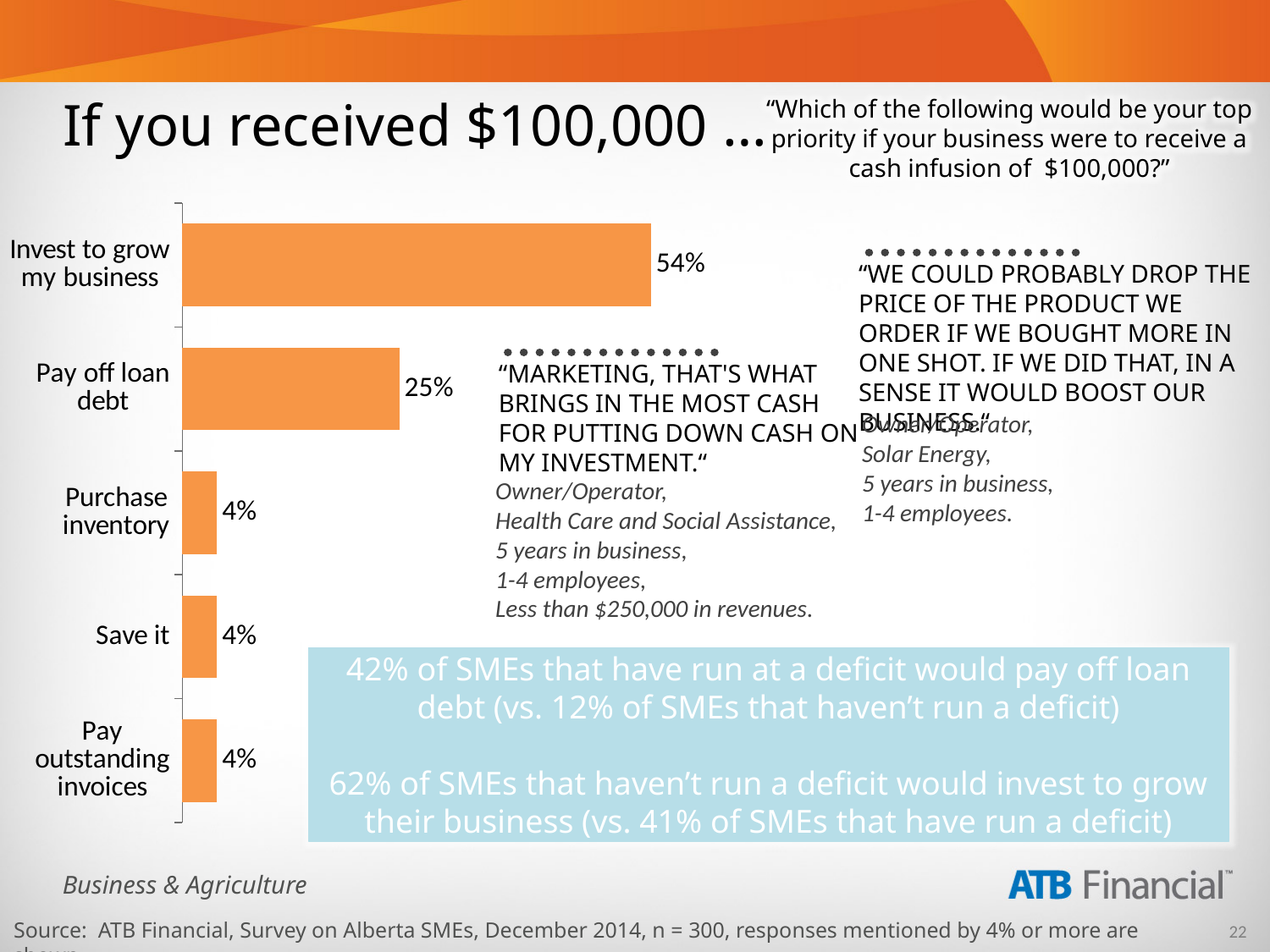
What is the difference between the values for 'Pay off loan debt' and 'Pay outstanding invoices'? 21 percentage points What percentage of respondents said they would invest to grow their business? 54% Which is larger: the value for 'Pay off loan debt' or the value for 'Save it'? Pay off loan debt What percentage of respondents said they would purchase inventory? 4% What kind of chart is shown on the slide? Bar chart What is the difference between the values for 'Invest to grow my business' and 'Pay off loan debt'? 29 percentage points How many categories are shown in the chart? 5 How many categories in the chart have a value of 4%? 3 What percentage of respondents said they would pay off loan debt? 25% What is the title of the chart on the slide? If you received $100,000 … Which category has the highest value in the chart? Invest to grow my business What percentage of respondents said they would save it? 4%